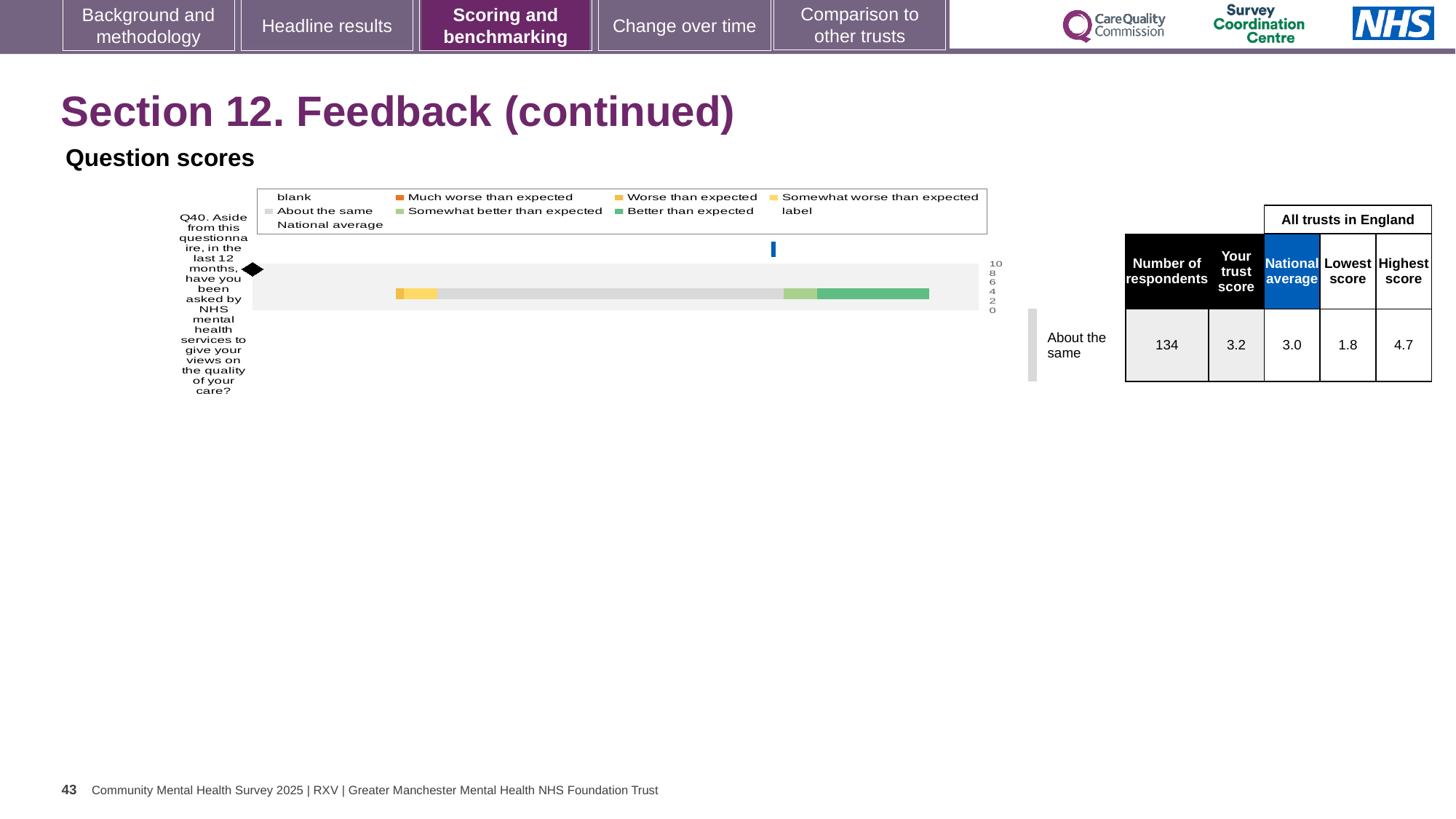
In the table beside the chart, what is the lowest score among all trusts in England for Q40? 1.8 What is the difference between the highest score (4.7) and the lowest score (1.8) for Q40 in the table beside the chart? 2.9 How many questions (categories) are plotted in the chart? 1 What benchmarking rating is shown for Q40 next to the chart? About the same In the table beside the chart, what is the highest score among all trusts in England for Q40? 4.7 In the table beside the chart, what is 'Your trust score' for Q40? 3.2 In the table beside the chart, what is the national average for Q40? 3.0 Which question is plotted in the chart? Q40. Aside from this questionnaire, in the last 12 months, have you been asked by NHS mental health services to give your views on the quality of your care? What is the highest value shown on the chart's axis? 10 What kind of chart is shown under 'Question scores'? bar chart In the table beside the chart, what is the number of respondents for Q40? 134 Is the trust score for Q40 (3.2) larger or smaller than the national average (3.0)? larger